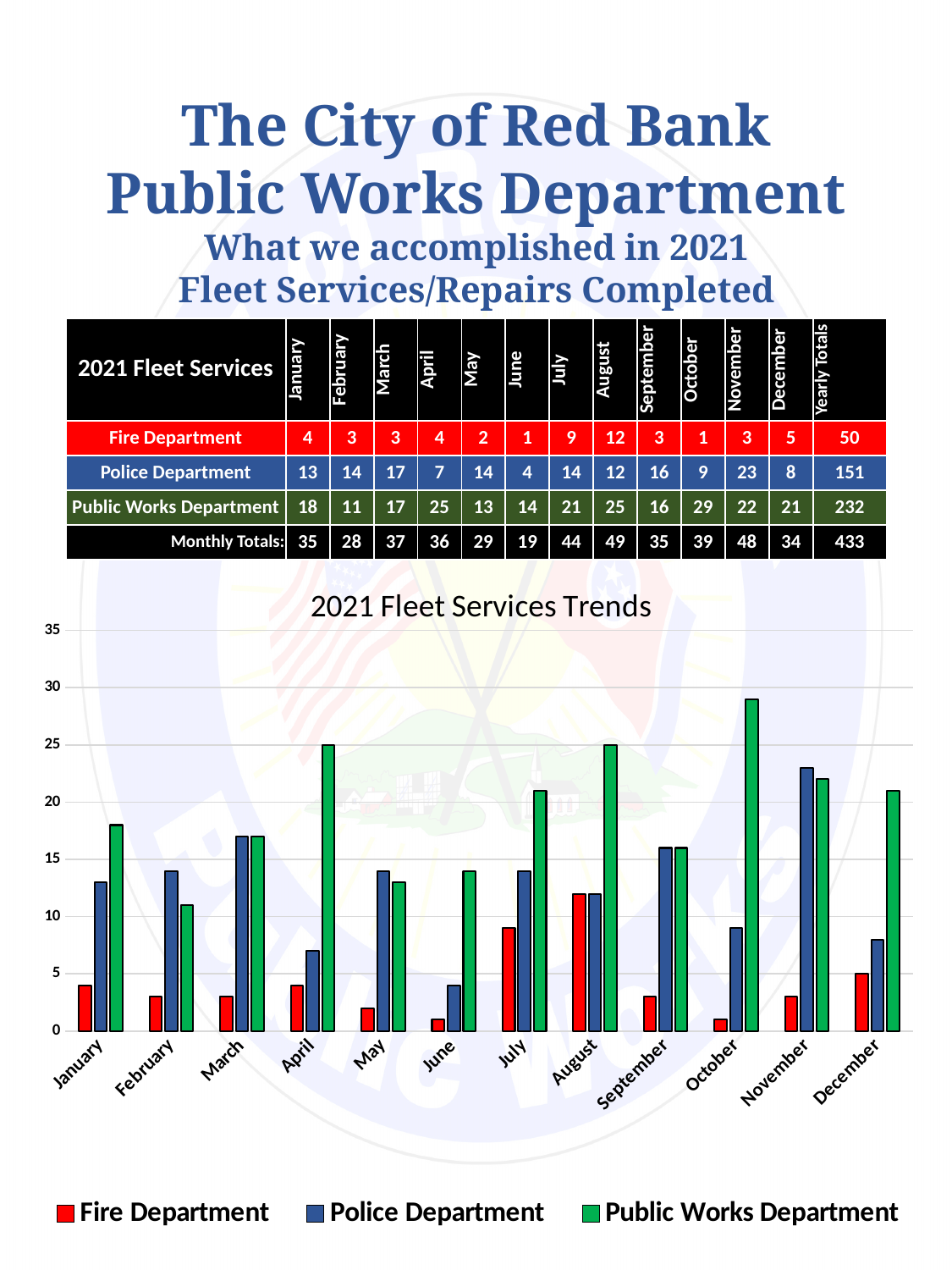
In the "2021 Fleet Services Trends" chart, do the Fire Department values rise or fall from June to August? rise In the "2021 Fleet Services Trends" chart, which month has the lowest Police Department bar? June What is the title of the chart on the slide? 2021 Fleet Services Trends In the "2021 Fleet Services Trends" chart, which is larger in April: the Police Department or the Public Works Department? Public Works Department How many series does the legend of the "2021 Fleet Services Trends" chart list? 3 In the "2021 Fleet Services Trends" chart, what is the difference between the Public Works Department and the Fire Department values in August? 13 In the "2021 Fleet Services Trends" chart, what is the value for the Public Works Department in October? 29 How many months are shown along the x axis of the "2021 Fleet Services Trends" chart? 12 In the "2021 Fleet Services Trends" chart, is the value for the Public Works Department in April greater or less than 20? greater In the "2021 Fleet Services Trends" chart, what is the value for the Police Department in November? 23 What kind of chart is the "2021 Fleet Services Trends" chart? bar chart In the "2021 Fleet Services Trends" chart, which month has the highest Public Works Department bar? October